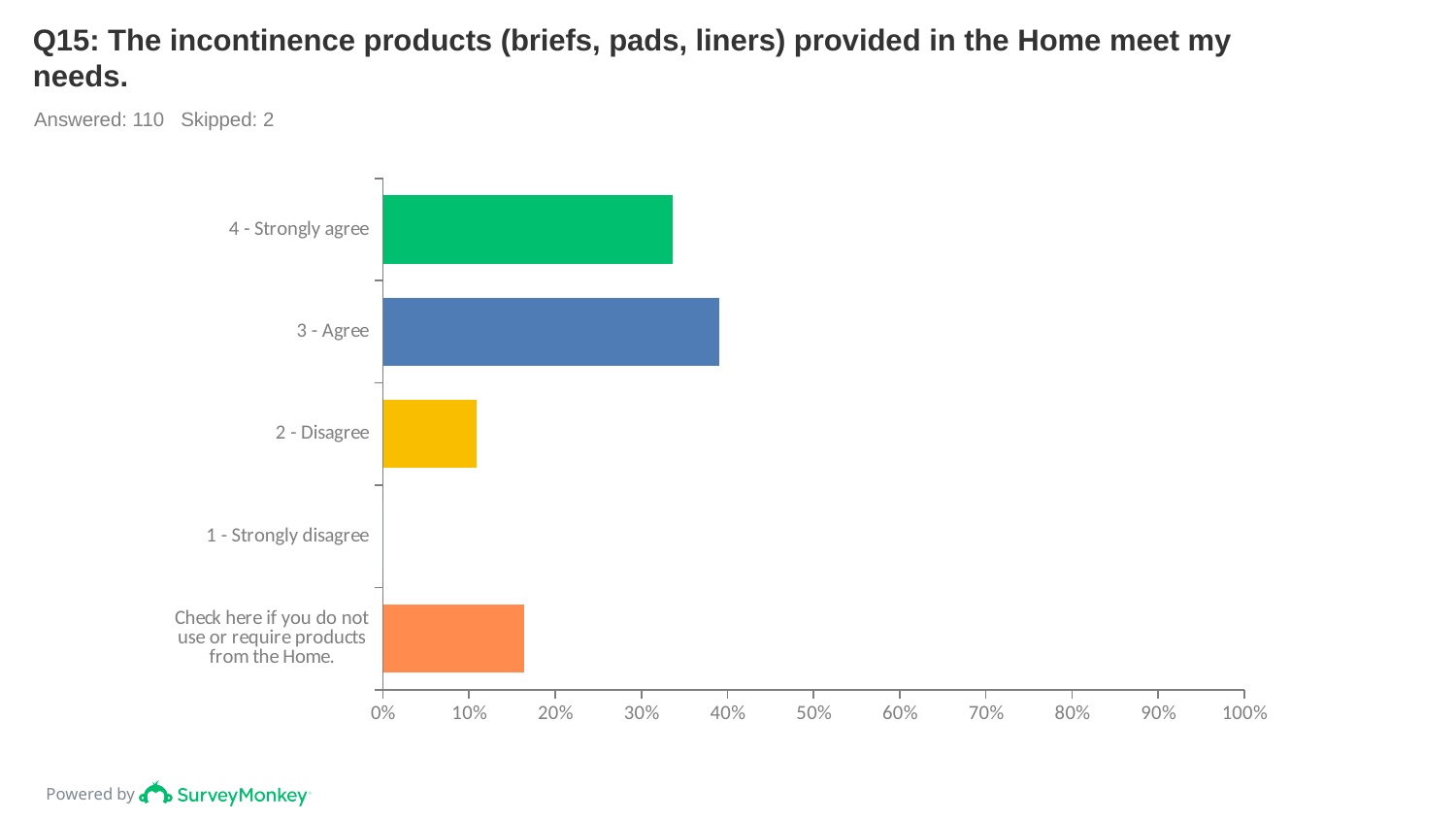
Which is larger, the value for 4 - Strongly agree or the value for 2 - Disagree? 4 - Strongly agree How many response categories are shown on the chart? 5 Which response category has the highest value? 3 - Agree How many respondents answered this question according to the slide? 110 Which response category has the lowest value? 1 - Strongly disagree Which is larger, the value for 'Check here if you do not use or require products from the Home.' or the value for 2 - Disagree? Check here if you do not use or require products from the Home. What kind of chart is shown on the slide? bar chart Is the value for 'Check here if you do not use or require products from the Home.' greater or less than 20%? less Is the value for 'Check here if you do not use or require products from the Home.' greater or less than 10%? greater Is the value for 3 - Agree greater or less than 30%? greater